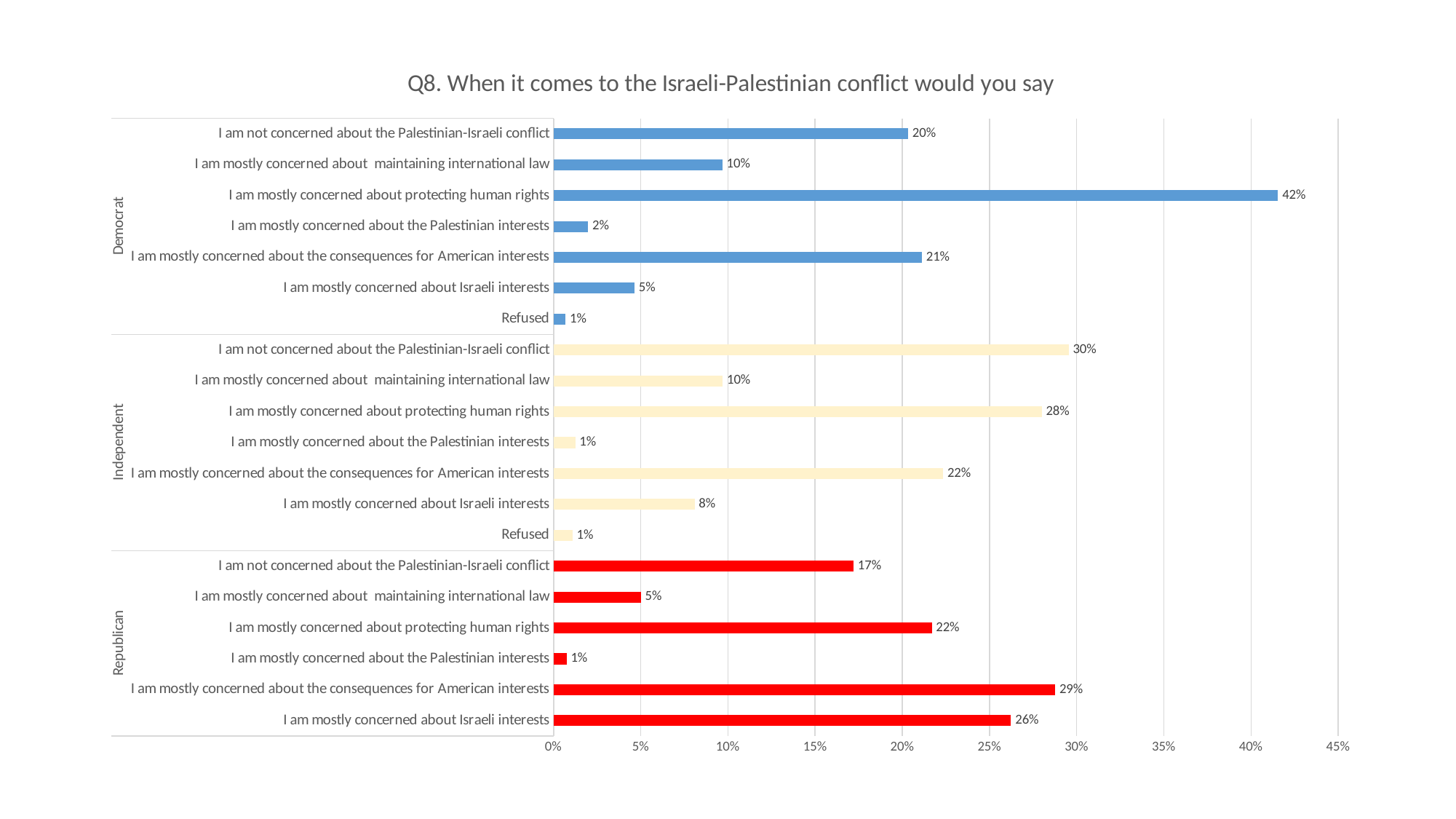
Which is larger: the Independent value for 'I am mostly concerned about Israeli interests' or the Democrat value for the same response? Independent What is the title of the chart? Q8. When it comes to the Israeli-Palestinian conflict would you say What is the difference between the Democrat and Republican values for 'I am mostly concerned about protecting human rights'? 20% What percentage of Democrats said they are mostly concerned about protecting human rights? 42% Which response has the lowest value among Democrats? Refused What colour are the bars for the Republican group? Red How many bars are shown in the Republican group? 6 What percentage of Republicans said they are mostly concerned about Israeli interests? 26% What percentage of Independents said they are not concerned about the Palestinian-Israeli conflict? 30% What kind of chart is shown on the slide? Bar chart Is the Democrat value for 'I am mostly concerned about the consequences for American interests' greater or less than 20%? greater Which response has the highest value among Republicans? I am mostly concerned about the consequences for American interests